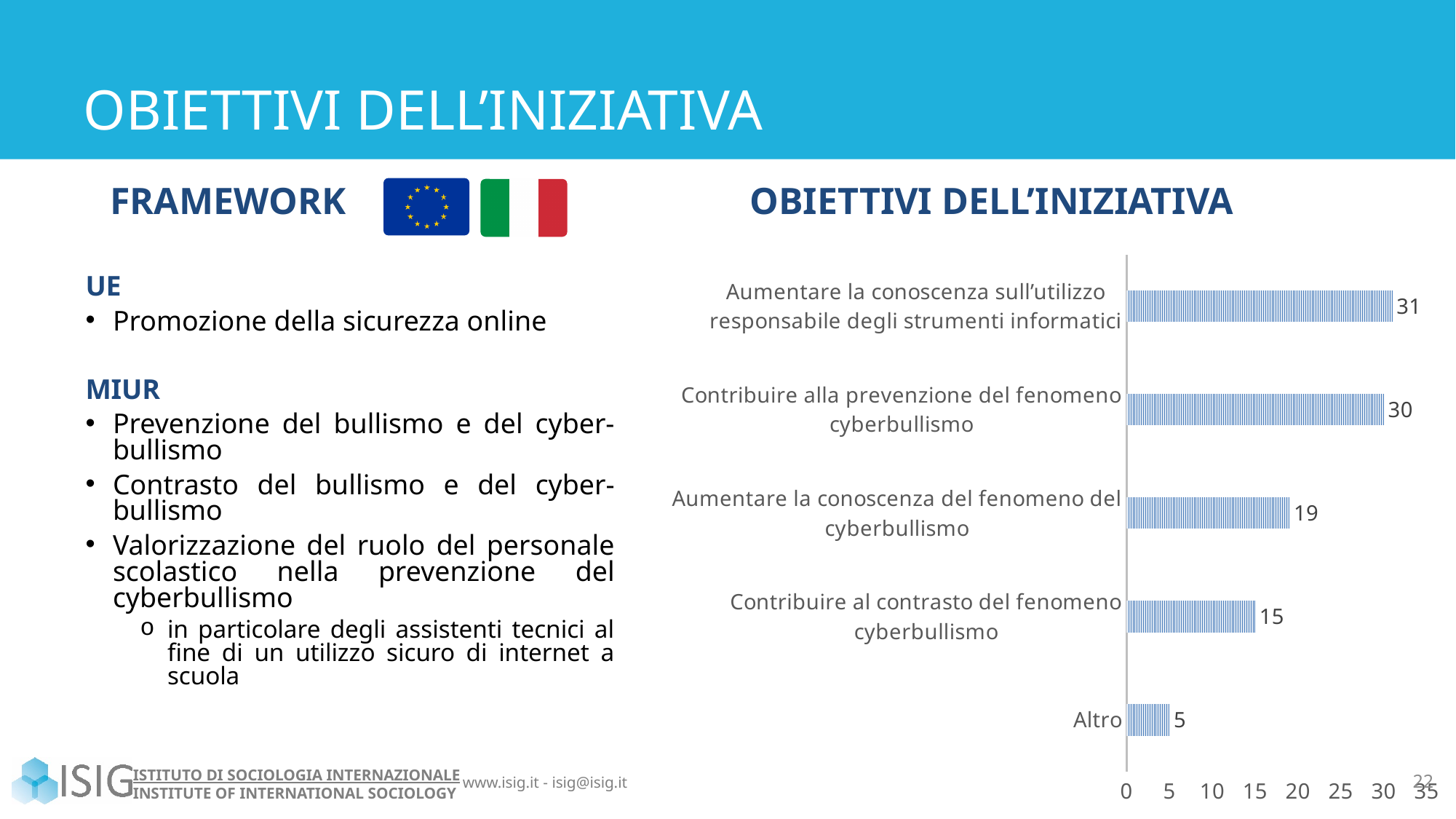
Which category has the highest value? Aumentare la conoscenza sull'utilizzo responsabile degli strumenti informatici What is the value for 'Contribuire al contrasto del fenomeno cyberbullismo'? 15 What is the value for 'Aumentare la conoscenza del fenomeno del cyberbullismo'? 19 How many categories are shown in the chart? 5 What is the value for 'Altro'? 5 What kind of chart is shown on the slide? Bar chart What is the value for 'Contribuire alla prevenzione del fenomeno cyberbullismo'? 30 Which is larger: the value for 'Contribuire alla prevenzione del fenomeno cyberbullismo' or the value for 'Aumentare la conoscenza del fenomeno del cyberbullismo'? Contribuire alla prevenzione del fenomeno cyberbullismo What is the value for 'Aumentare la conoscenza sull'utilizzo responsabile degli strumenti informatici'? 31 What is the title of the chart? OBIETTIVI DELL'INIZIATIVA What is the difference between the values for 'Aumentare la conoscenza del fenomeno del cyberbullismo' and 'Contribuire al contrasto del fenomeno cyberbullismo'? 4 Which category has the lowest value? Altro